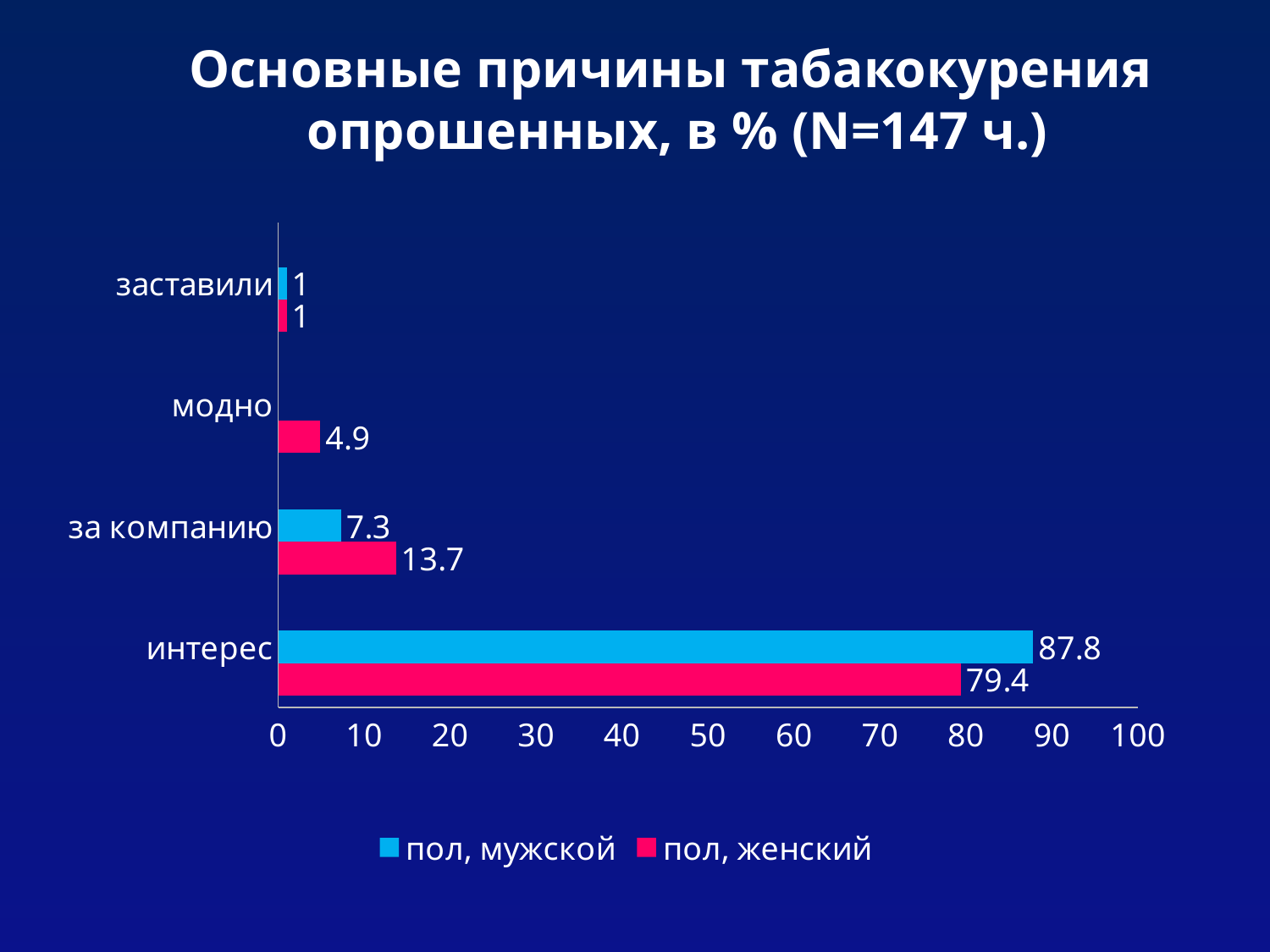
How many series does the legend list? 2 What is the value for "интерес" in the "пол, мужской" series? 87.8 What is the value for "модно" in the "пол, женский" series? 4.9 For "за компанию", which series has the larger value, "пол, мужской" or "пол, женский"? пол, женский What is the difference between the "пол, женский" values for "за компанию" and "модно"? 8.8 Which category has the highest value in the "пол, женский" series? интерес What colour represents the "пол, женский" series? pink What is the difference between the "пол, мужской" and "пол, женский" values for "интерес"? 8.4 Which category has the lowest value in the "пол, мужской" series among those with a plotted bar? заставили What kind of chart is shown on the slide? bar chart What is the value for "за компанию" in the "пол, женский" series? 13.7 How many categories are shown on the chart? 4